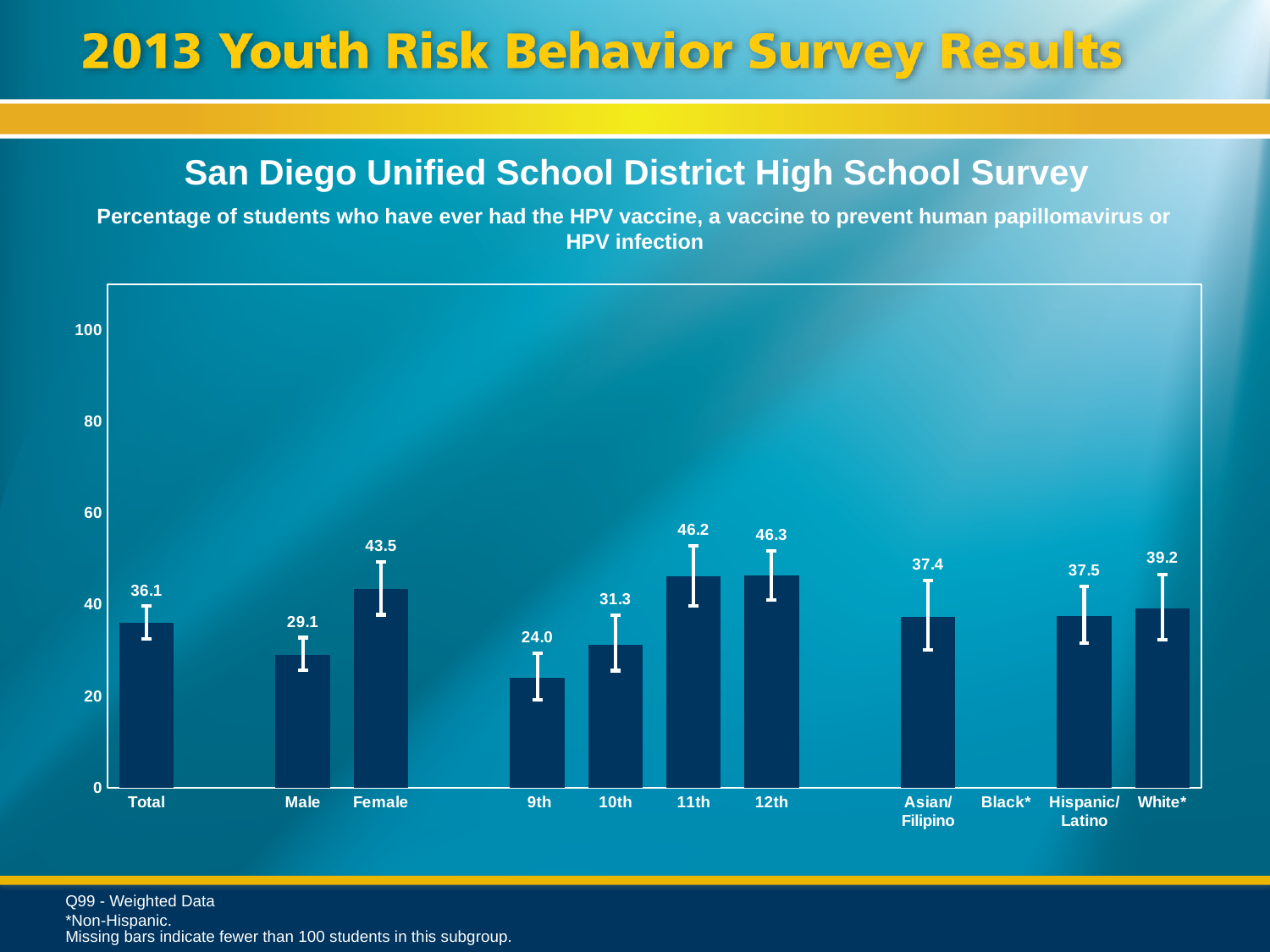
What is the difference between the Female and Male values? 14.4 Which category label has no bar plotted? Black* Which is larger, the value for Male or the value for Female? Female What kind of chart is shown? bar chart What is the value for 9th grade? 24.0 What is the value for Hispanic/Latino? 37.5 Which category has the lowest value? 9th Do the values rise or fall from 9th grade to 12th grade? rise What is the value for Total? 36.1 What is the value for Female? 43.5 Is the value for White* greater or less than 40? less How many bars are plotted on the chart? 10